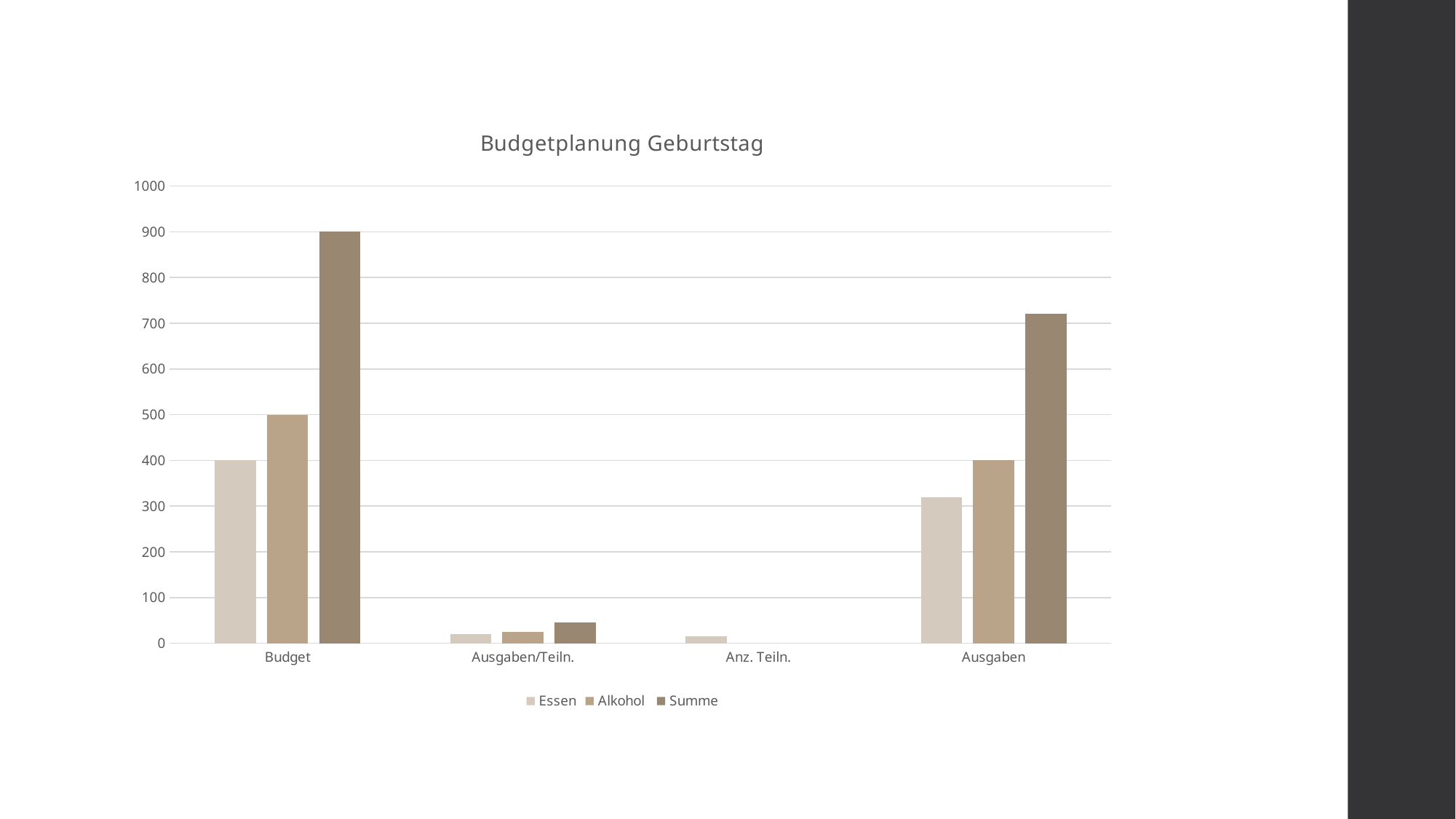
What type of chart is shown on the slide? bar chart What is the difference between Summe and Alkohol for Budget? 400 What is the value of Alkohol for Budget? 500 What is the value of Essen for Budget? 400 How many categories are shown on the x axis? 4 Is the value of Summe for Ausgaben greater or less than 700? greater How many series does the legend list? 3 Which category has the highest Summe value? Budget What is the title of the chart? Budgetplanung Geburtstag Which is larger: Essen for Budget or Essen for Ausgaben? Essen for Budget What is the value of Alkohol for Ausgaben? 400 What is the value of Summe for Budget? 900